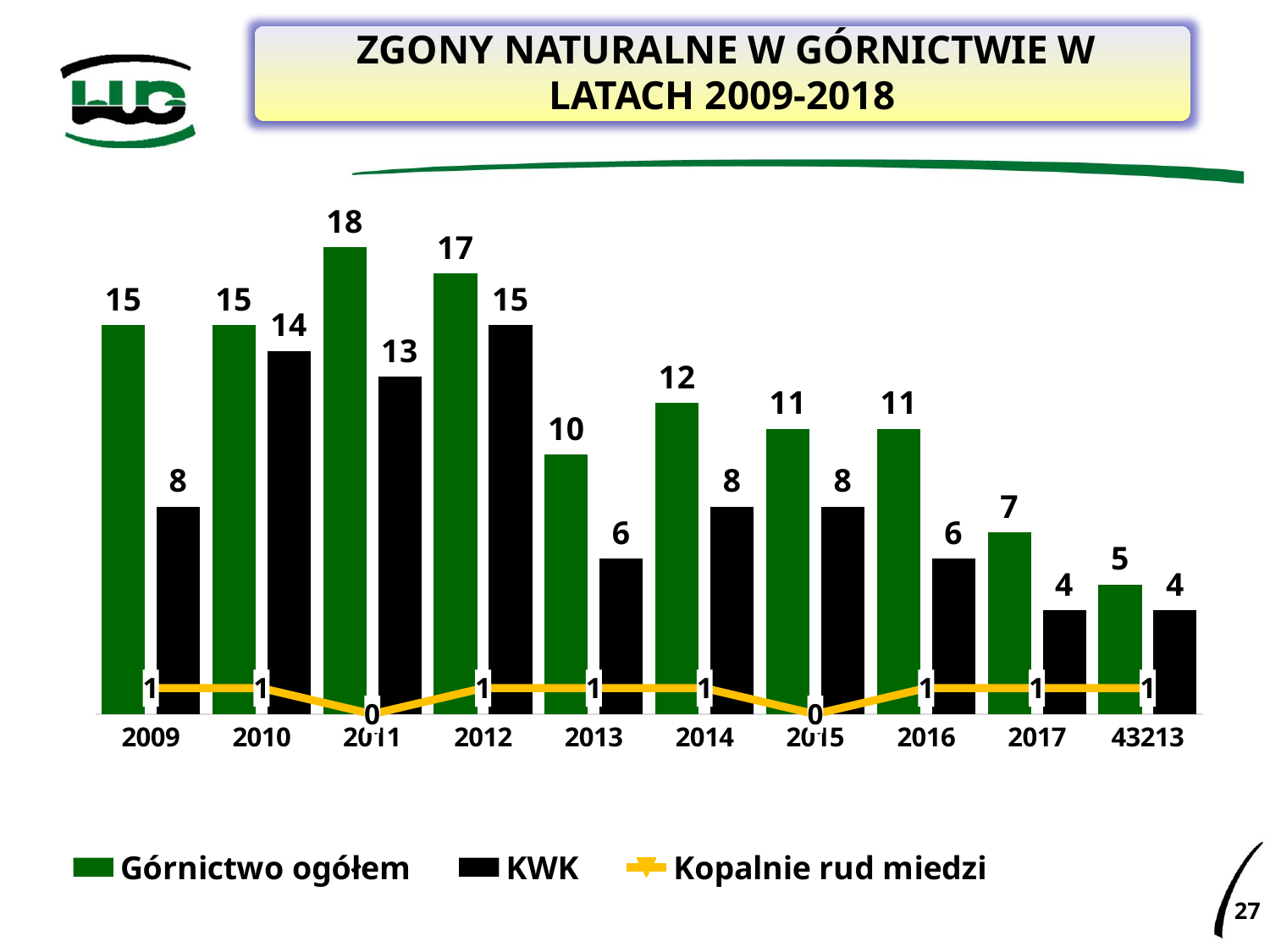
In which year is the value for Górnictwo ogółem highest? 2011 What is the value for Górnictwo ogółem in 2011? 18 What is the difference between Górnictwo ogółem and KWK in 2009? 7 What is the value for Kopalnie rud miedzi in 2015? 0 What is the value for KWK in 2012? 15 In which year is the value for KWK lowest? 2017 and 43213 (both 4) What kind of chart is this? Bar chart with a line series Which is larger in 2013: Górnictwo ogółem or KWK? Górnictwo ogółem How many series does the legend list? 3 Which series is shown in black? KWK How many years are shown on the x axis? 10 Does the value for Górnictwo ogółem rise or fall from 2014 to 2018? Fall